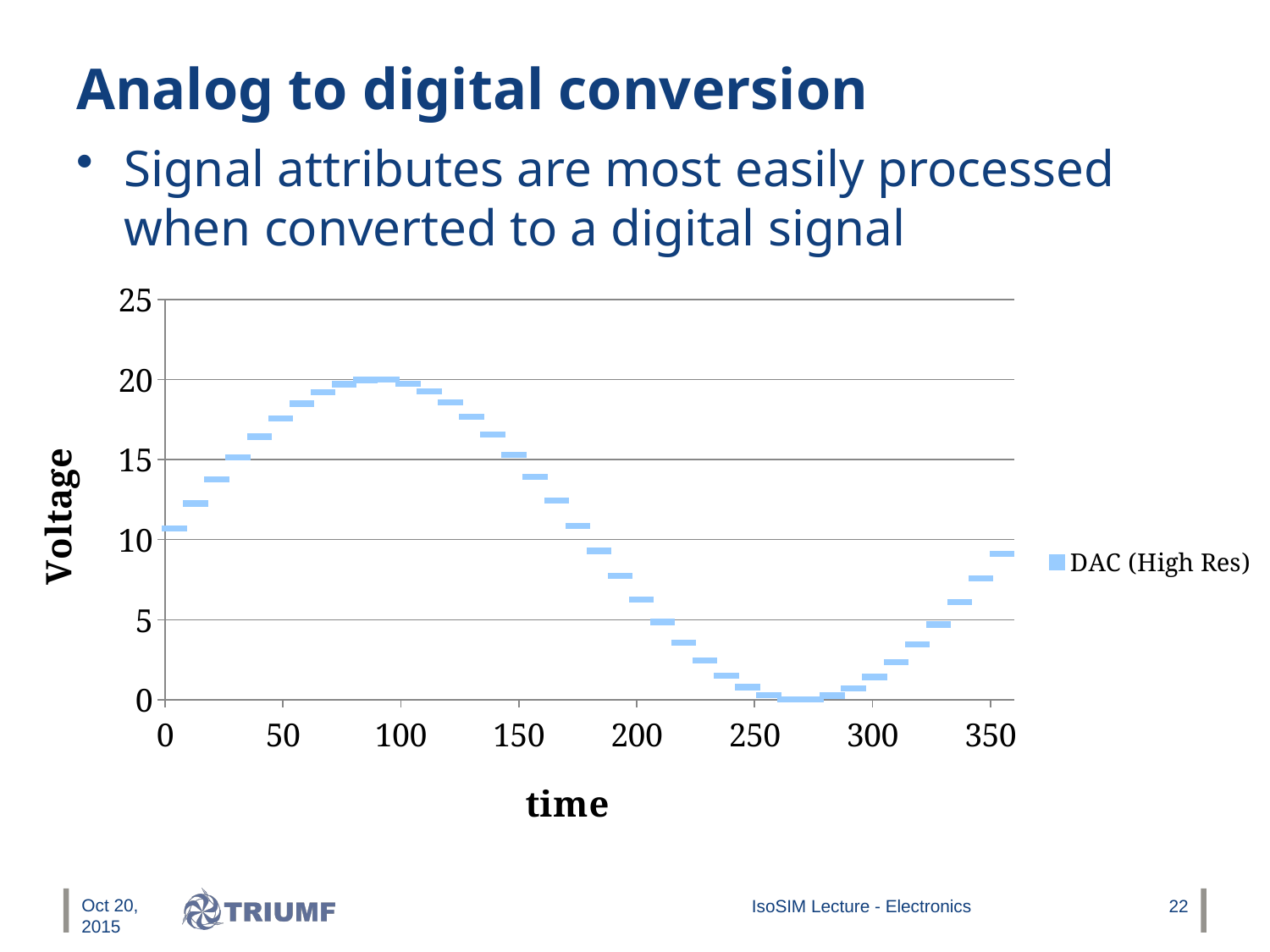
Is the value for DAC (High Res) at time 0 greater or less than 10? greater Is the highest value of DAC (High Res) greater or less than 15? greater What is the name of the series shown in the chart legend? DAC (High Res) Is the value for DAC (High Res) at time 200 greater or less than 10? less What is the title of the vertical axis of the chart? Voltage Do the DAC (High Res) values rise or fall as time goes from 0 to 100? rise What kind of chart is shown on the slide? scatter chart Do the DAC (High Res) values rise or fall as time goes from 100 to 250? fall Which is larger, the DAC (High Res) value at time 50 or at time 200? time 50 How many series does the chart legend list? 1